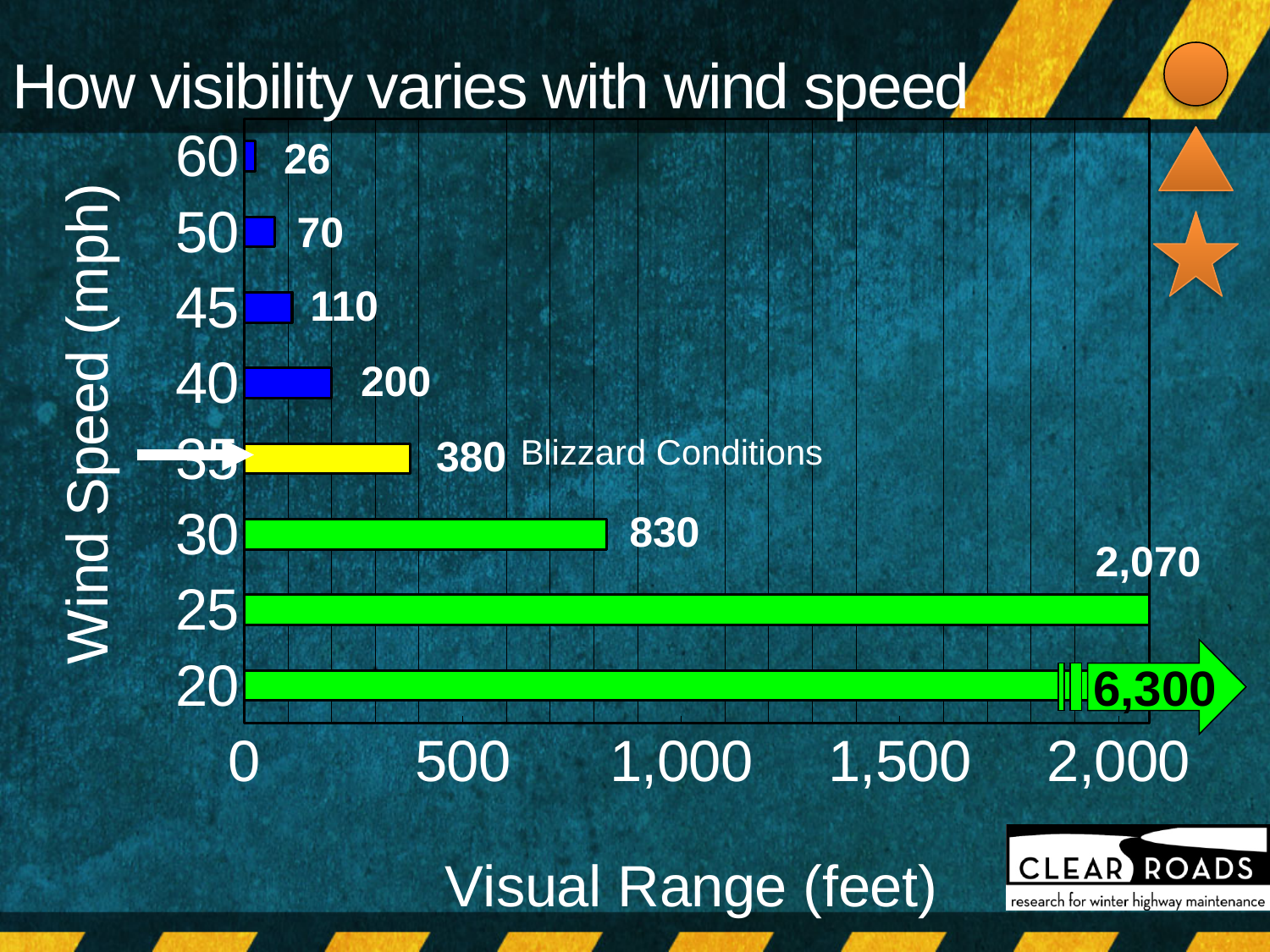
Which wind speed has the lowest visual range? 60 Which has a larger visual range, 45 mph or 50 mph? 45 mph As wind speed increases, does the visual range rise or fall? Fall What is the difference in visual range between 20 mph and 25 mph? 4,230 How many wind speed categories are shown in the chart? 8 What is the visual range in feet at a wind speed of 25 mph? 2,070 Which wind speed has the highest visual range? 20 What is the visual range in feet at a wind speed of 60 mph? 26 What is the visual range in feet at a wind speed of 40 mph? 200 What annotation is written next to the bar with a value of 380? Blizzard Conditions What kind of chart is shown on the slide? Bar chart What is the difference in visual range between 30 mph and 40 mph? 630